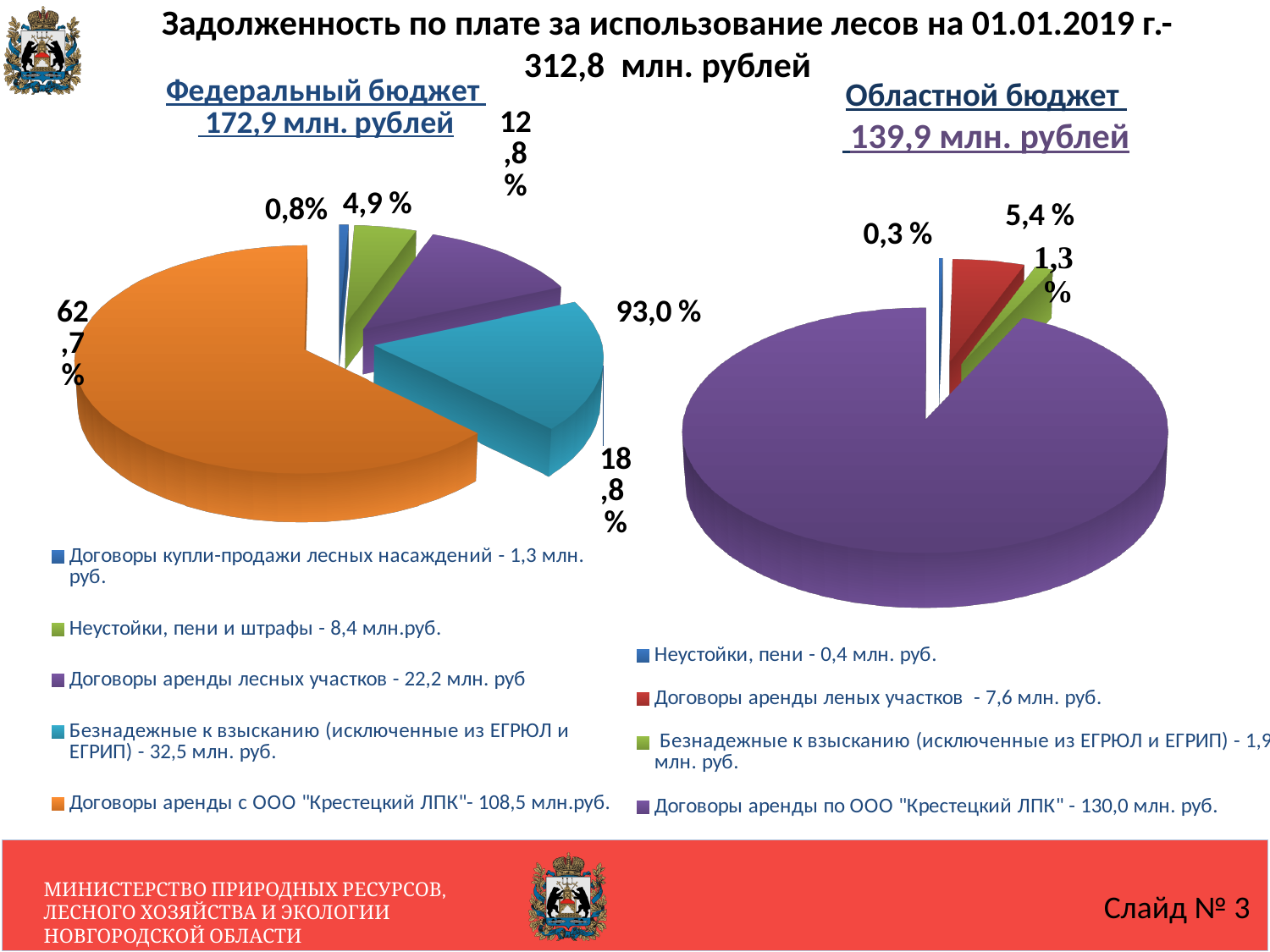
In the Федеральный бюджет pie chart, which category has the smallest share? Договоры купли-продажи лесных насаждений In the Федеральный бюджет pie chart, which category has the largest share? Договоры аренды с ООО "Крестецкий ЛПК" In the Областной бюджет pie chart, what is the difference in percentage points between Договоры аренды леных участков (5,4 %) and Безнадежные к взысканию (1,3 %)? 4,1 percentage points In the Федеральный бюджет pie chart, which is larger: the share for Неустойки, пени и штрафы or the share for Договоры аренды лесных участков? Договоры аренды лесных участков In the Федеральный бюджет pie chart, how many slices (categories) are shown? 5 In the Областной бюджет pie chart, what share is shown for Договоры аренды по ООО "Крестецкий ЛПК"? 93,0 % What kind of chart is used for the Федеральный бюджет data on the left? Pie chart In the Областной бюджет pie chart, which category has the smallest share? Неустойки, пени According to the slide title, what is the total debt for forest use as of 01.01.2019? 312,8 млн. рублей In the Федеральный бюджет pie chart, what share is shown for Договоры аренды лесных участков? 12,8 % In the Федеральный бюджет pie chart, what share is shown for Безнадежные к взысканию (исключенные из ЕГРЮЛ и ЕГРИП)? 18,8 % In the Областной бюджет pie chart, how many categories does the legend list? 4